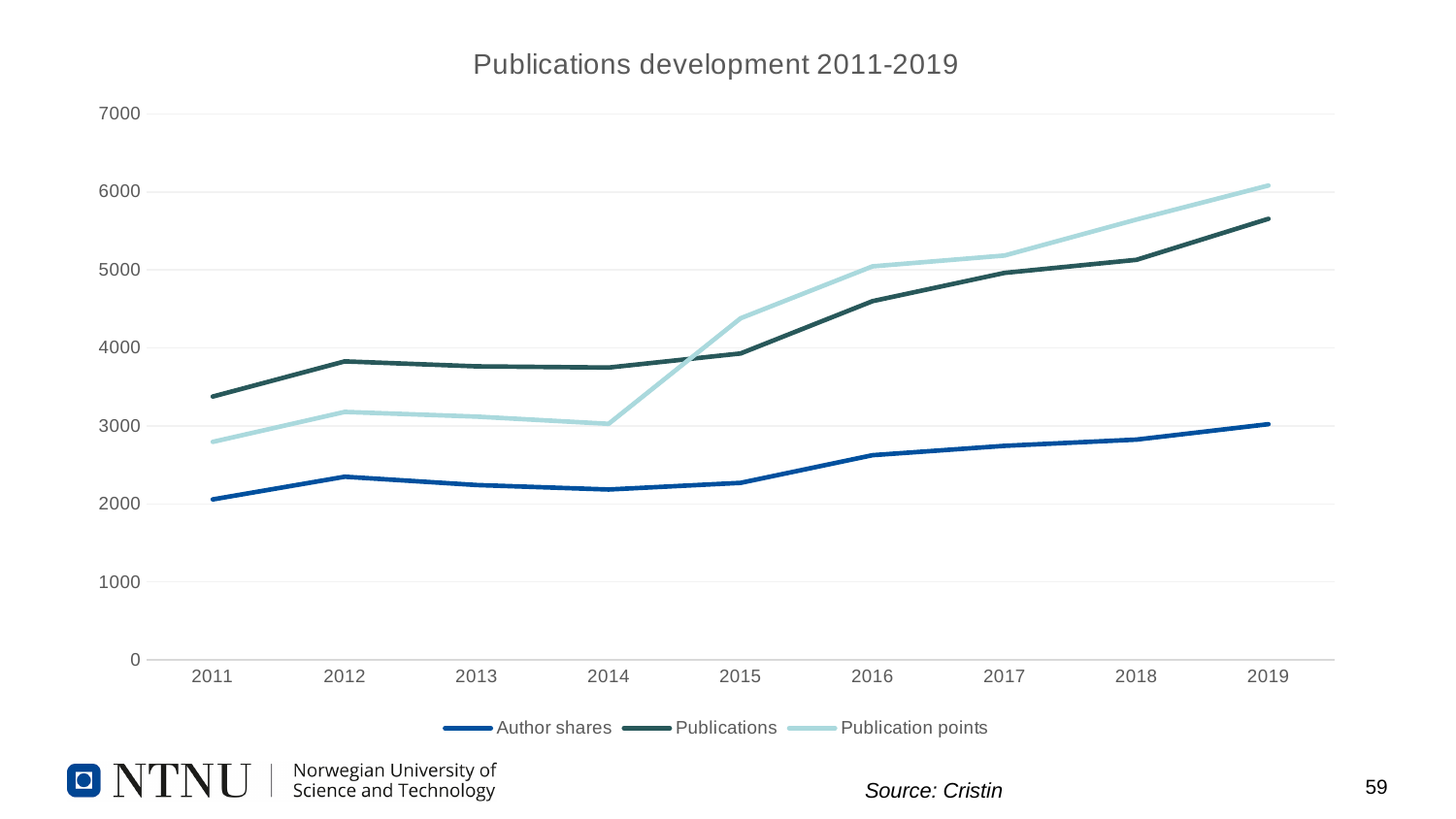
How many series does the legend list? 3 What source is cited for the chart data? Cristin Does the Publication points series rise or fall overall from 2011 to 2019? Rise What is the title of the chart? Publications development 2011-2019 In 2019, which is higher: Publications or Publication points? Publication points Is the value for Publications in 2011 greater or less than 3000? greater How many years are plotted along the x axis? 9 In 2011, which is higher: Publications or Publication points? Publications What kind of chart is shown on the slide? Line chart Is the value for Publication points in 2011 greater or less than 3000? less Is the value for Publications in 2019 greater or less than 6000? less